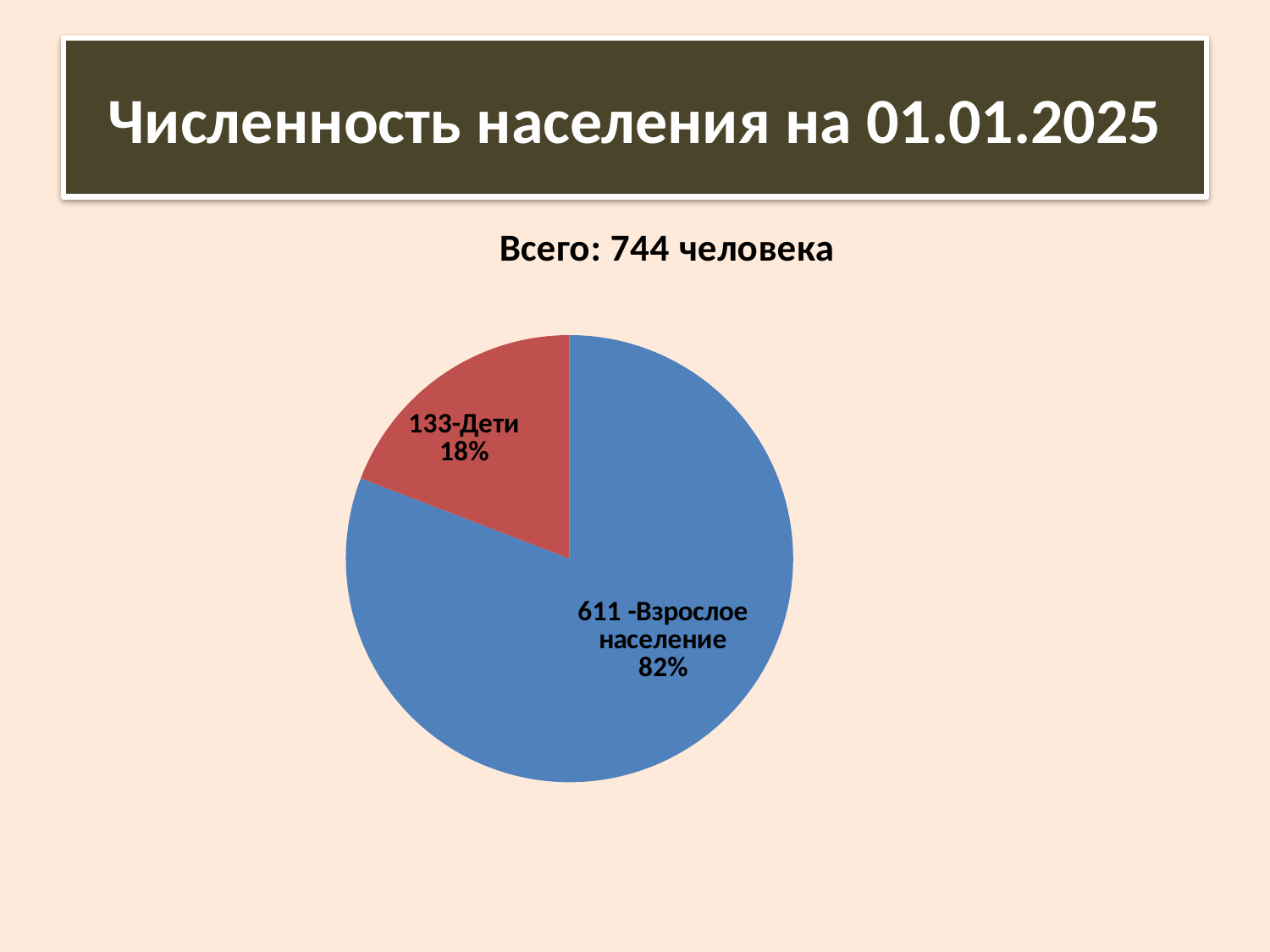
What share of the pie does the "Взрослое население" slice represent? 82% How many people are in the "Взрослое население" category? 611 How many slices does the pie chart have? 2 Which category has the largest slice of the pie? Взрослое население Which is larger: the "Дети" slice or the "Взрослое население" slice? Взрослое население Which category has the smallest slice of the pie? Дети What is the difference in number of people between "Взрослое население" and "Дети"? 478 What type of chart is shown on the slide? Pie chart What colour is the "Дети" slice? Red What share of the pie does the "Дети" slice represent? 18% What is the total population stated on the slide? 744 человека How many people are in the "Дети" category? 133